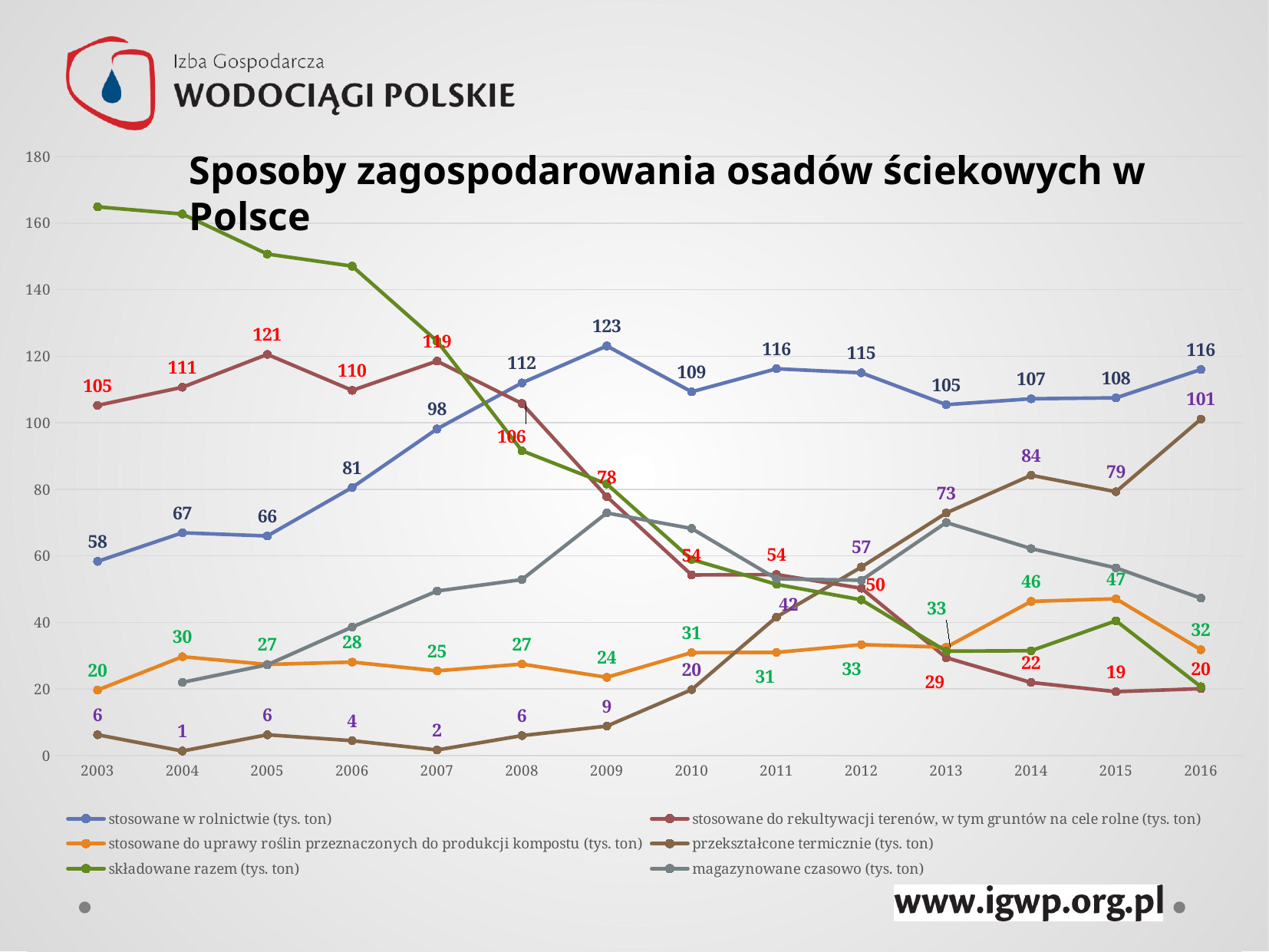
What is the value for 'przekształcone termicznie (tys. ton)' in 2016? 101 In which year is 'przekształcone termicznie (tys. ton)' lowest? 2004 What is the difference between the 2003 and 2016 values for 'stosowane do rekultywacji terenów, w tym gruntów na cele rolne (tys. ton)'? 85 Does the value for 'przekształcone termicznie (tys. ton)' rise or fall from 2010 to 2014? rise How many years are shown on the x axis? 14 In which year is 'stosowane w rolnictwie (tys. ton)' highest? 2009 What is the value for 'stosowane w rolnictwie (tys. ton)' in 2009? 123 What kind of chart is shown on the slide? line chart In 2016, which is larger: 'stosowane w rolnictwie (tys. ton)' or 'przekształcone termicznie (tys. ton)'? stosowane w rolnictwie (tys. ton) What is the value for 'stosowane do rekultywacji terenów, w tym gruntów na cele rolne (tys. ton)' in 2005? 121 How many series does the legend list? 6 Is the value for 'składowane razem (tys. ton)' in 2003 greater or less than 160? greater